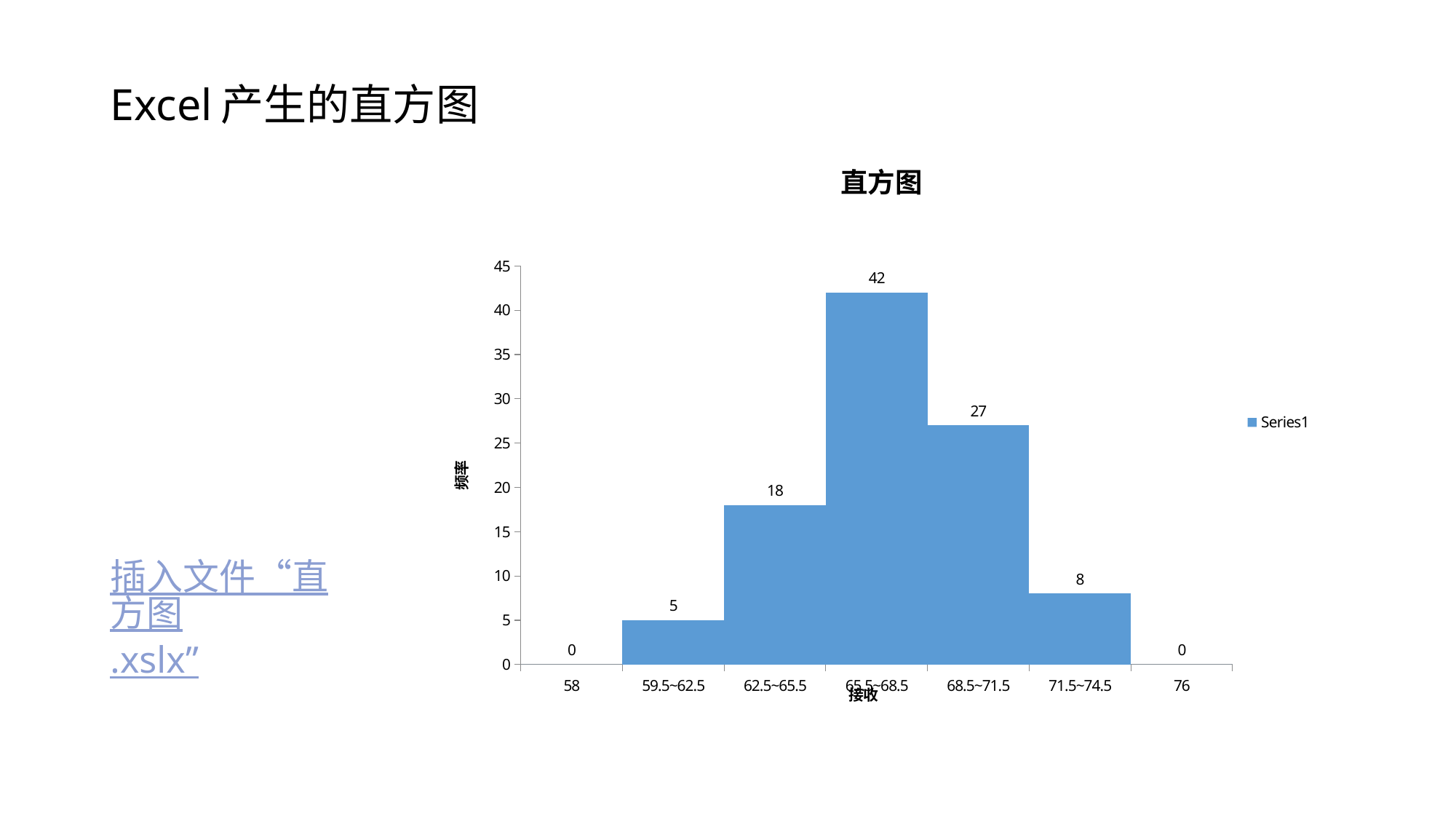
What is the value for the 65.5~68.5 category? 42 What is the value for the 59.5~62.5 category? 5 What is the difference between the values for 62.5~65.5 and 59.5~62.5? 13 What is the title of the chart? 直方图 How many categories are shown on the x axis? 7 Is the value for 68.5~71.5 greater or less than 25? greater What is the value for the 71.5~74.5 category? 8 What is the difference between the values for 65.5~68.5 and 68.5~71.5? 15 Which category has the highest value? 65.5~68.5 What kind of chart is shown? bar chart How many series does the legend list? 1 Which is larger, the value for 62.5~65.5 or the value for 71.5~74.5? 62.5~65.5